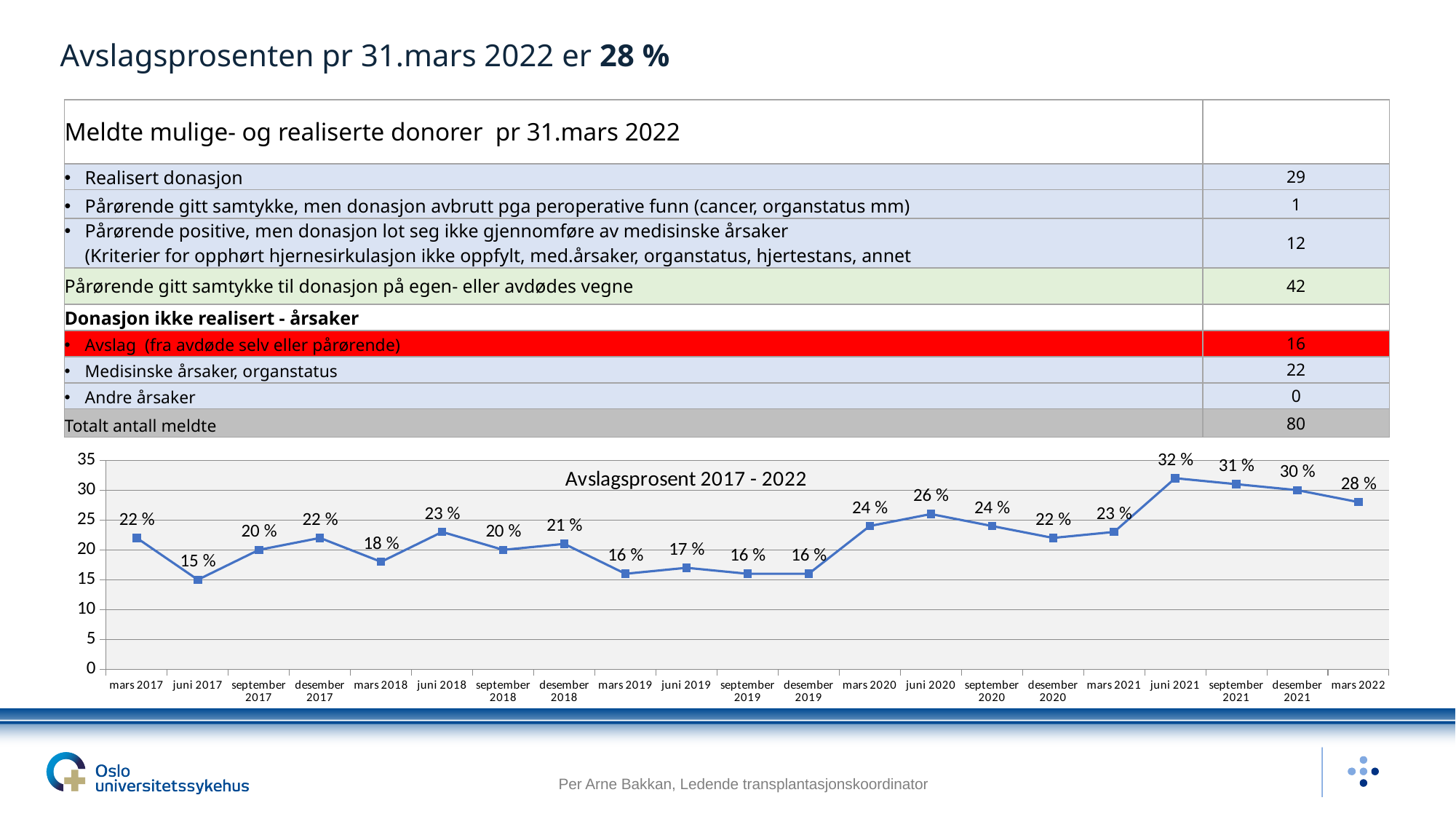
What is the value for mars 2022? 28 % Which is larger, the value for mars 2018 or the value for juni 2018? juni 2018 What type of chart is shown on the slide? line chart Do the values rise or fall from juni 2021 to mars 2022? fall What is the value for juni 2017? 15 % What is the value for juni 2020? 26 % What is the title of the chart? Avslagsprosent 2017 - 2022 Which period has the highest value? juni 2021 What is the difference between the values for mars 2020 and desember 2019? 8 % Which period has the lowest value? juni 2017 How many data points are plotted on the chart? 21 What is the difference between the values for juni 2021 and mars 2022? 4 %